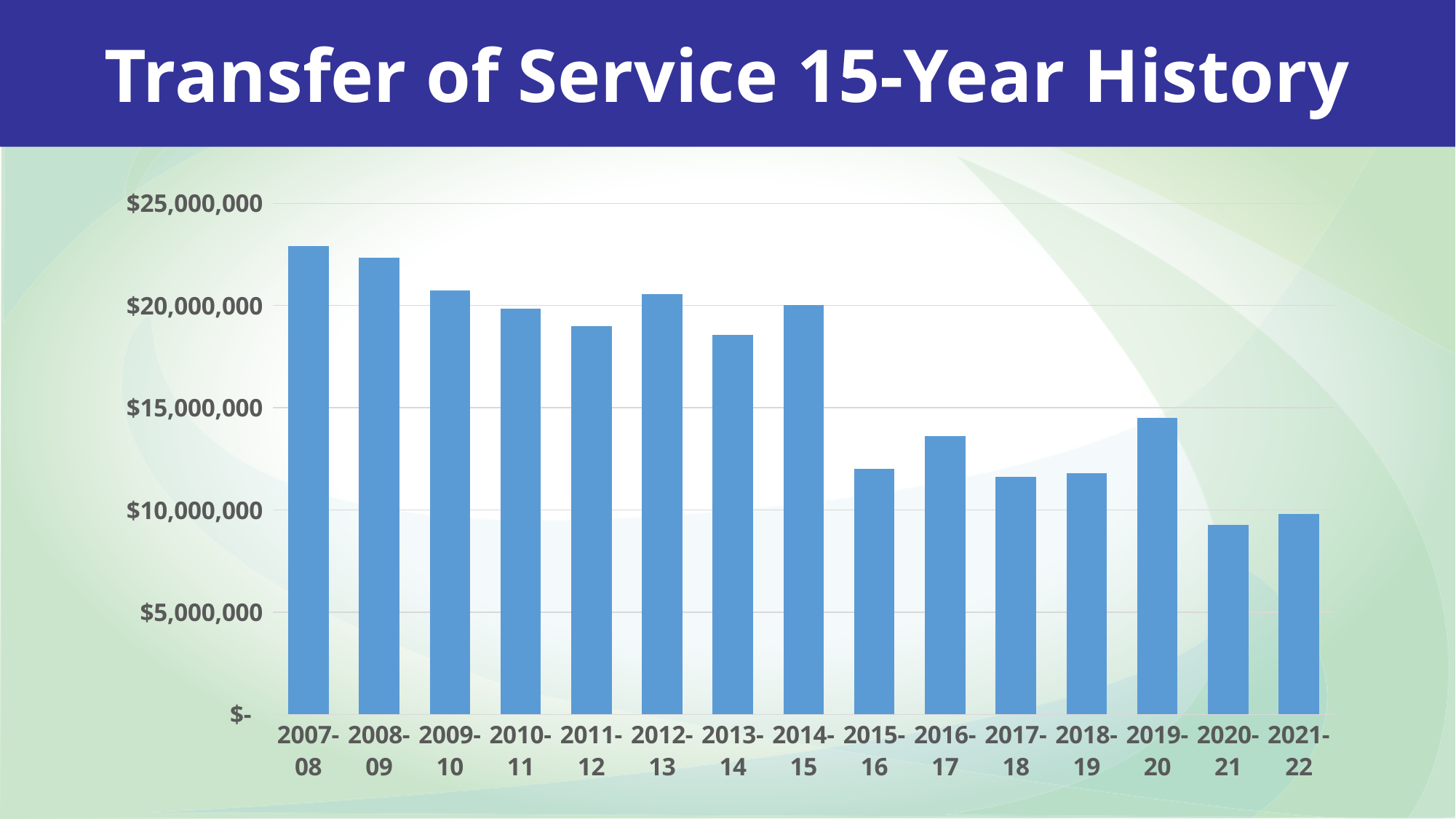
Which fiscal year has the lowest value? 2020-21 Is the value for 2015-16 greater or less than $10,000,000? greater What is the title of the chart? Transfer of Service 15-Year History Overall, do the values rise or fall from 2007-08 to 2021-22? Fall Which is larger, the value for 2012-13 or the value for 2011-12? 2012-13 Is the value for 2020-21 greater or less than $10,000,000? less Is the value for 2007-08 greater or less than $20,000,000? greater How many fiscal years are plotted on the chart? 15 Which is larger, the value for 2019-20 or the value for 2016-17? 2019-20 Which fiscal year has the highest value? 2007-08 What kind of chart is shown on the slide? Bar chart